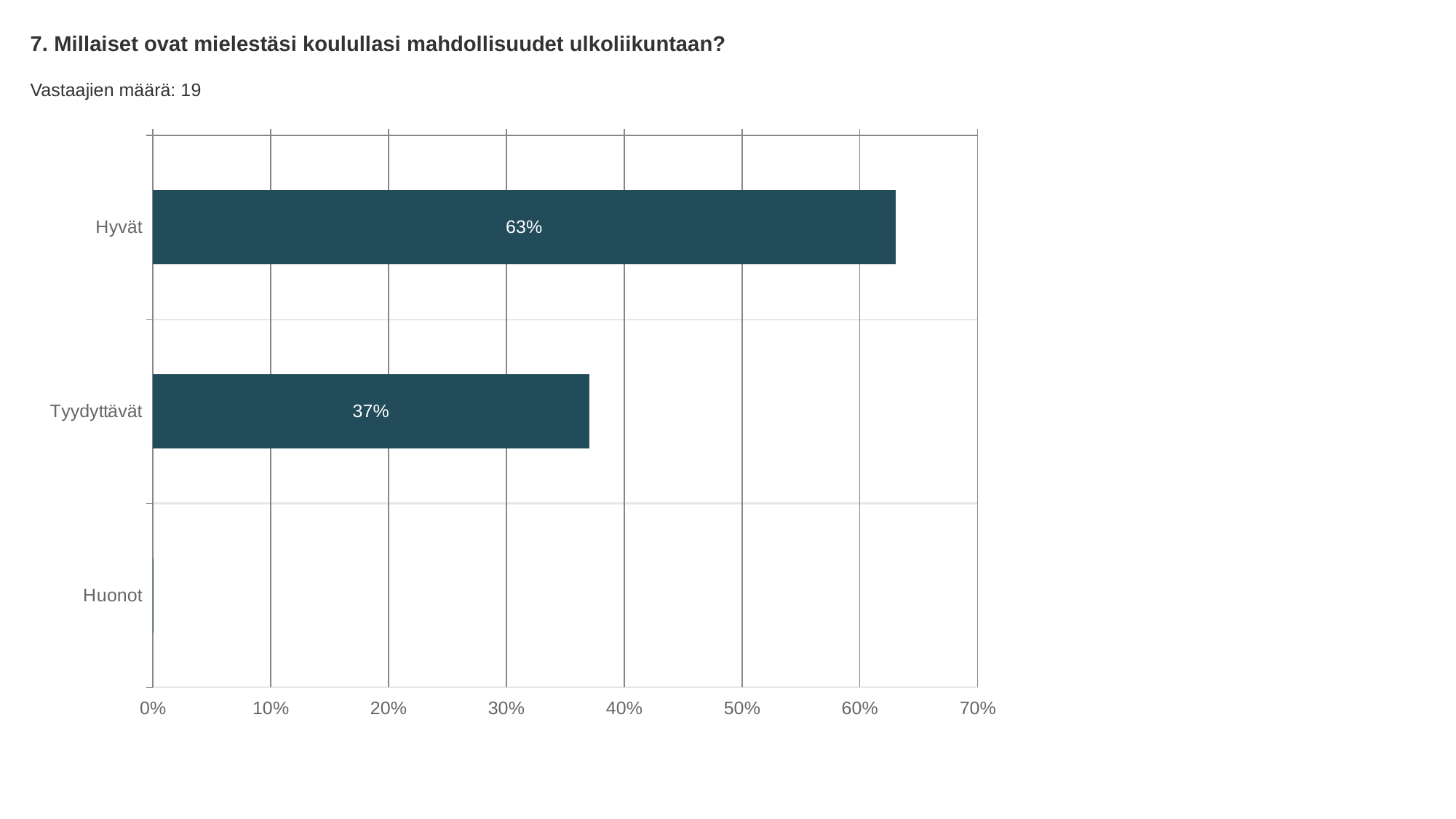
Which is larger, the value for Hyvät or the value for Tyydyttävät? Hyvät Which category has the lowest value? Huonot Is the value for Hyvät greater or less than 60%? greater Which category has the highest value? Hyvät What is the highest value shown on the x axis? 70% What is the number of respondents (Vastaajien määrä) stated on the slide? 19 What is the value for Hyvät? 63% Is the value for Tyydyttävät greater or less than 40%? less What kind of chart is shown on the slide? bar chart How many categories are shown in the chart? 3 What is the value for Tyydyttävät? 37% What is the difference between the values for Hyvät and Tyydyttävät? 26%